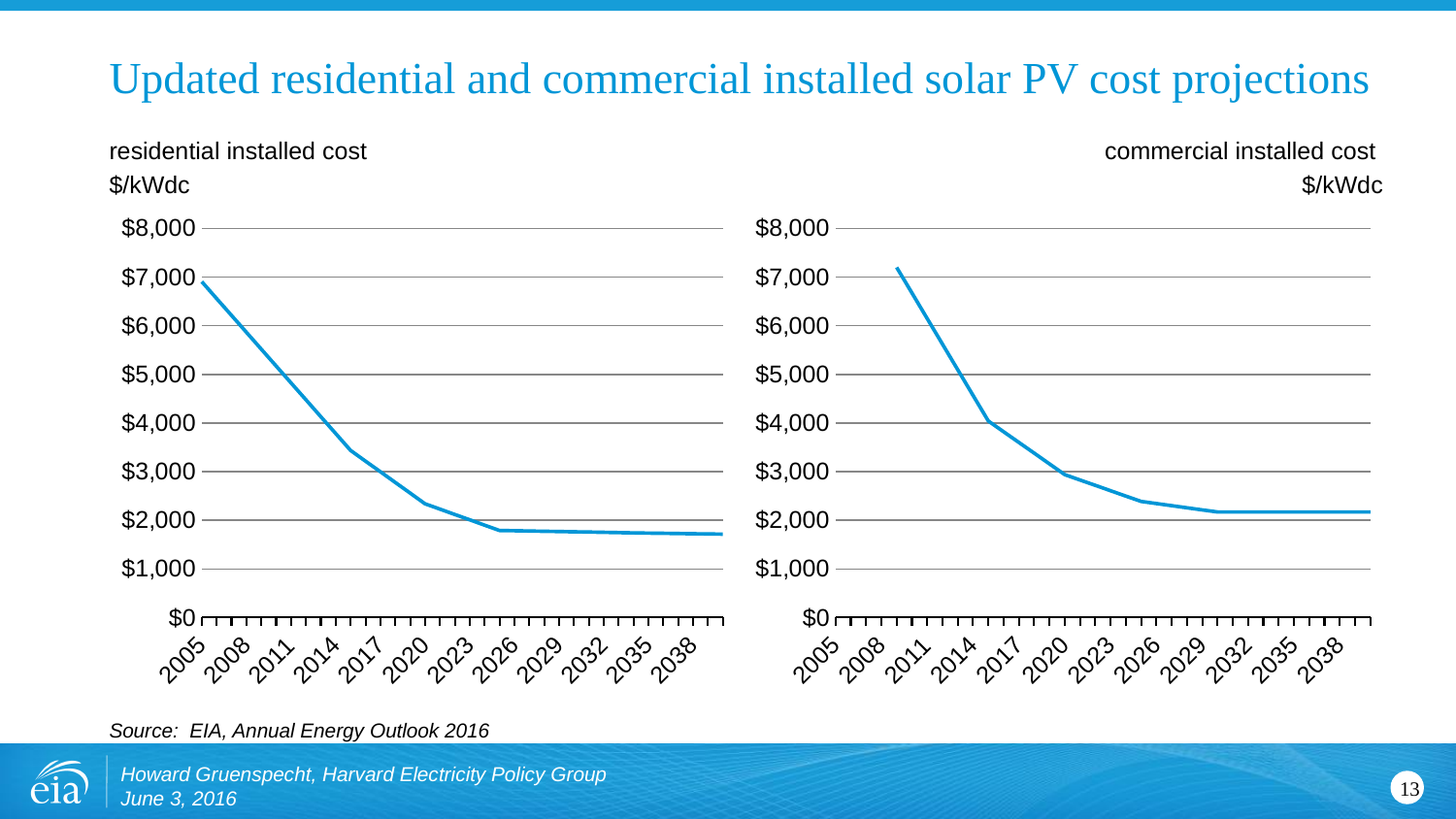
In the residential installed cost chart, which year has the highest value? 2005 In the commercial installed cost chart, which is larger, the value for 2011 or the value for 2029? 2011 In the residential installed cost chart, do values rise or fall from 2005 to 2038? fall In the residential installed cost chart, is the value for 2005 greater or less than $6,000? greater What is the title of the slide containing the two charts? Updated residential and commercial installed solar PV cost projections In the residential installed cost chart, is the value for 2014 greater or less than $4,000? less In the commercial installed cost chart, is the value for 2038 greater or less than $3,000? less What kind of chart is the residential installed cost chart? line chart What unit is shown on the y axis of the commercial installed cost chart? $/kWdc In the commercial installed cost chart, do values rise or fall along the x axis? fall